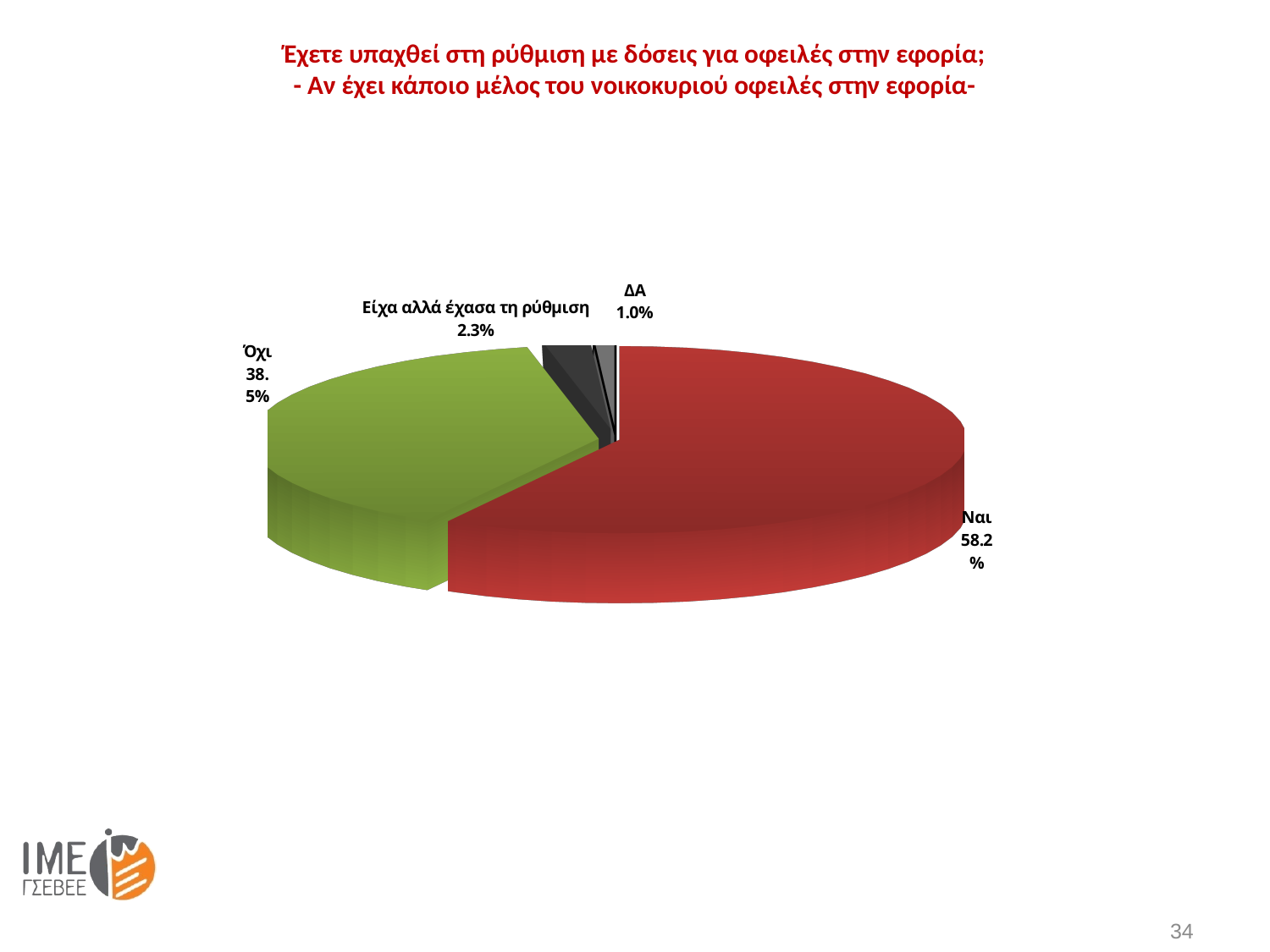
What kind of chart is shown on the slide? Pie chart Which category has the largest share of the pie? Ναι Which category has the smallest share of the pie? ΔΑ What colour is the slice for "Όχι"? Green Which is larger, the share for "Είχα αλλά έχασα τη ρύθμιση" or the share for "ΔΑ"? Είχα αλλά έχασα τη ρύθμιση What percentage of respondents answered "Όχι"? 38.5% How many categories are shown in the pie chart? 4 What is the value shown for "Είχα αλλά έχασα τη ρύθμιση"? 2.3% What percentage of respondents answered "Ναι"? 58.2% What is the difference in percentage points between "Ναι" and "Όχι"? 19.7 What is the value shown for "ΔΑ"? 1.0% What colour is the slice for "Ναι"? Red